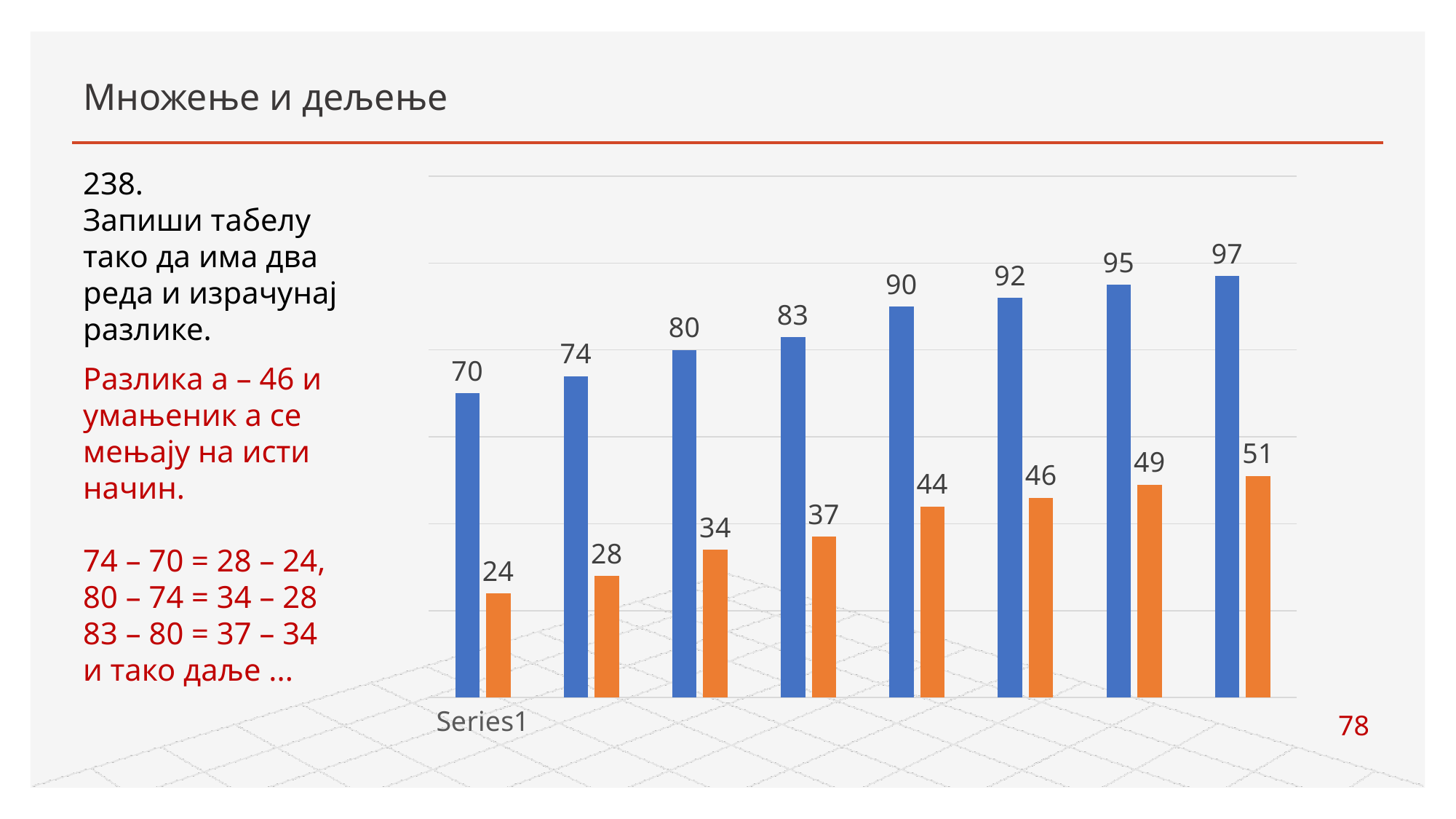
Which is larger, the fourth blue bar or the fourth orange bar? the fourth blue bar (83) What is the highest value among the blue bars? 97 What category label is printed below the chart's horizontal axis? Series1 Do the blue bar values rise or fall from left to right? rise What kind of chart is shown on the slide? bar chart What is the value of the first (leftmost) blue bar? 70 How many pairs of blue and orange bars are plotted in the chart? 8 What is the value of the first (leftmost) orange bar? 24 What is the difference between the first blue bar (70) and the first orange bar (24)? 46 What is the lowest value among the orange bars? 24 What is the value of the last (rightmost) orange bar? 51 What is the difference between the blue bar labelled 90 and the orange bar next to it? 46